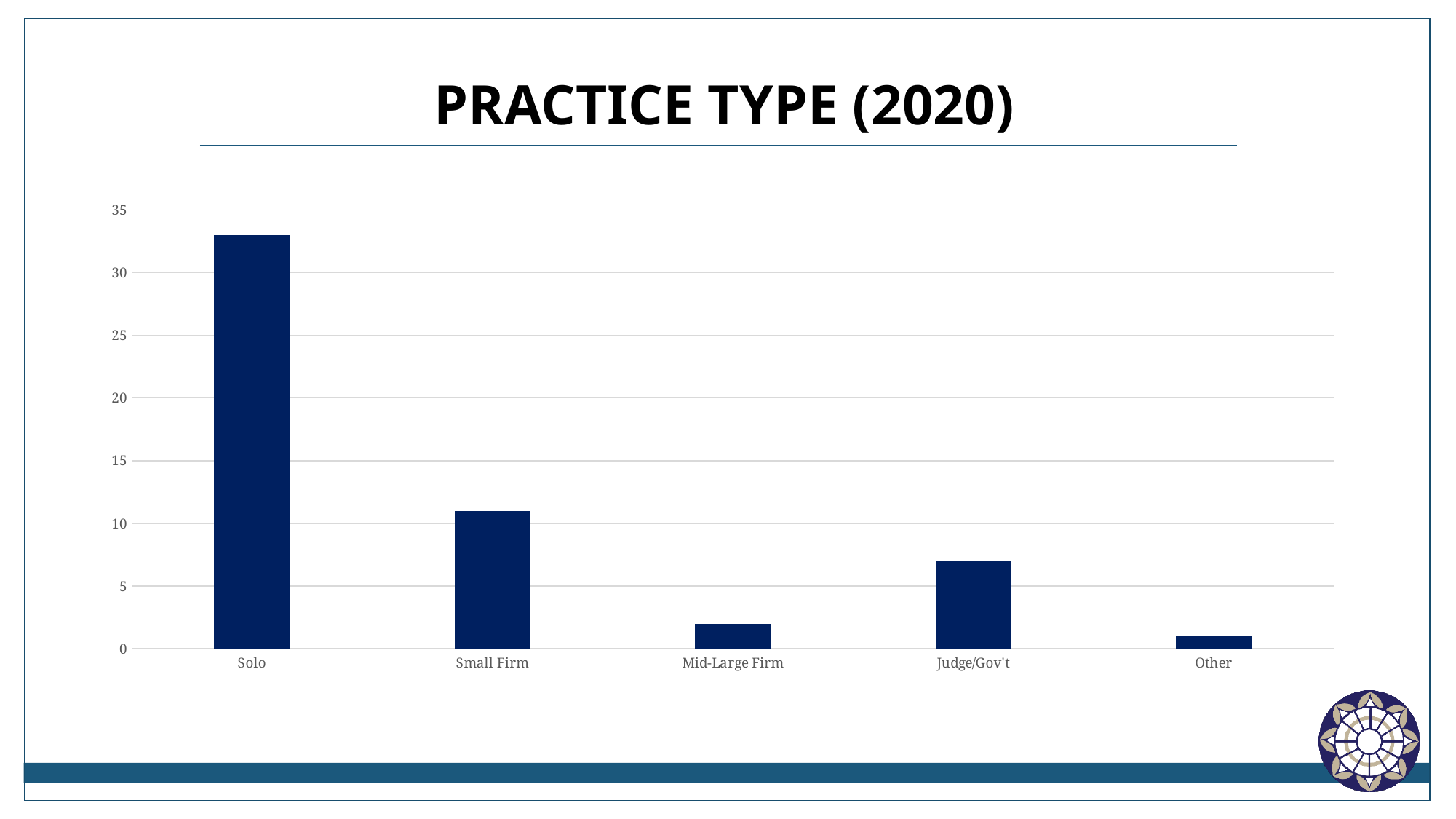
What kind of chart is shown on the slide? bar chart How many practice type categories are shown on the x axis? 5 What is the title of the chart? PRACTICE TYPE (2020) Which is larger, the value for Small Firm or the value for Judge/Gov't? Small Firm Which is larger, the value for Mid-Large Firm or the value for Judge/Gov't? Judge/Gov't Is the value for Solo greater or less than 30? greater Is the value for Judge/Gov't greater or less than 5? greater Is the value for Other greater or less than 5? less Which practice type has the highest value? Solo Which practice type has the lowest value? Other